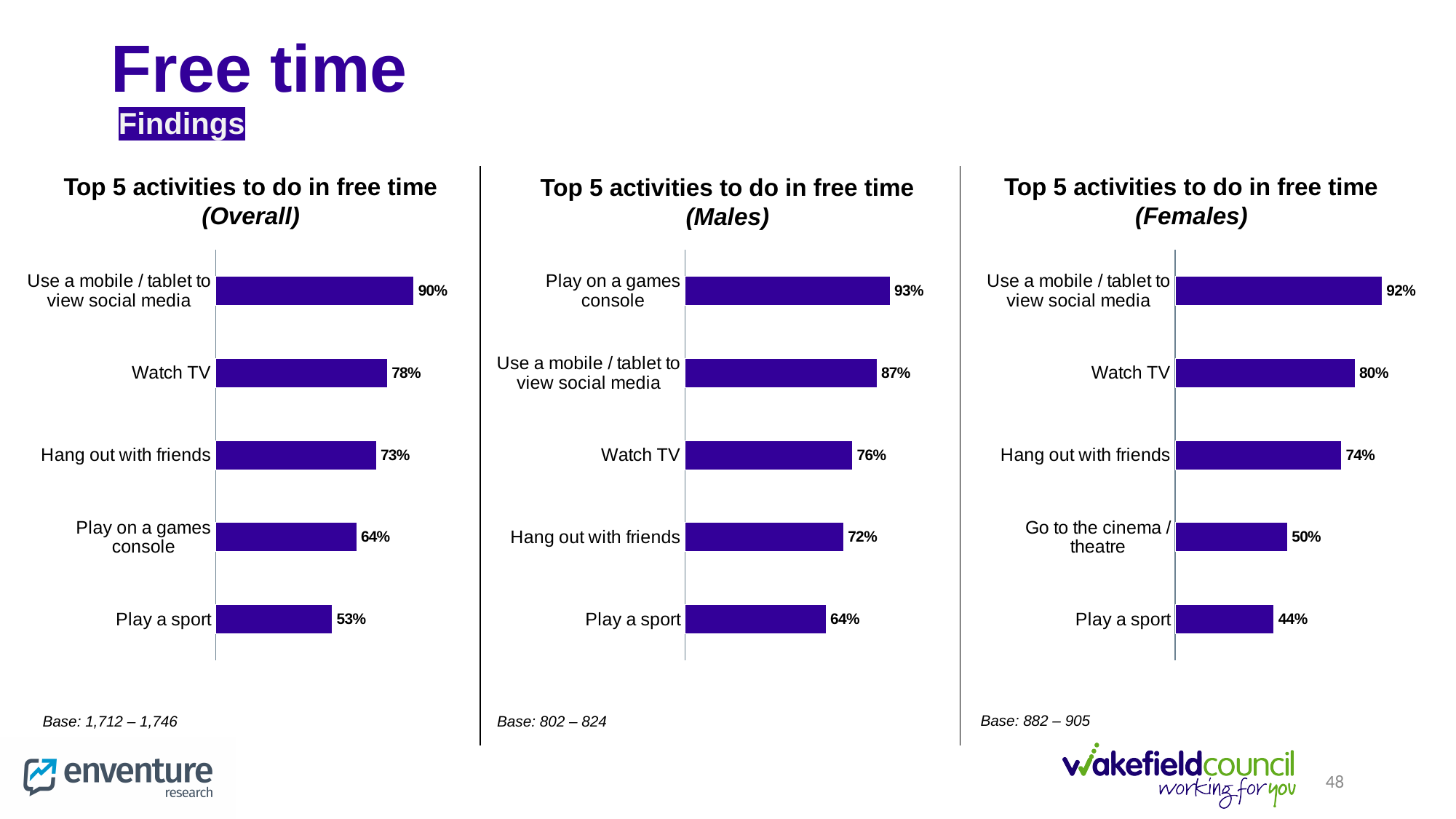
In the 'Top 5 activities to do in free time (Overall)' chart, what is the value for Watch TV? 78% What base is stated below the 'Top 5 activities to do in free time (Females)' chart? 882 – 905 In the 'Top 5 activities to do in free time (Overall)' chart, what is the difference between Watch TV and Hang out with friends? 5% In the 'Top 5 activities to do in free time (Males)' chart, what is the difference between Play on a games console and Play a sport? 29% In the 'Top 5 activities to do in free time (Females)' chart, which activity has the lowest value? Play a sport What kind of chart is the 'Top 5 activities to do in free time (Overall)' chart? Bar chart How many activities are shown in the 'Top 5 activities to do in free time (Males)' chart? 5 In the 'Top 5 activities to do in free time (Males)' chart, what is the value for Play on a games console? 93% In the 'Top 5 activities to do in free time (Females)' chart, what is the value for Go to the cinema / theatre? 50% In the 'Top 5 activities to do in free time (Overall)' chart, which activity has the highest value? Use a mobile / tablet to view social media In the 'Top 5 activities to do in free time (Males)' chart, what is the value for Hang out with friends? 72% In the 'Top 5 activities to do in free time (Females)' chart, which is larger: Watch TV or Hang out with friends? Watch TV